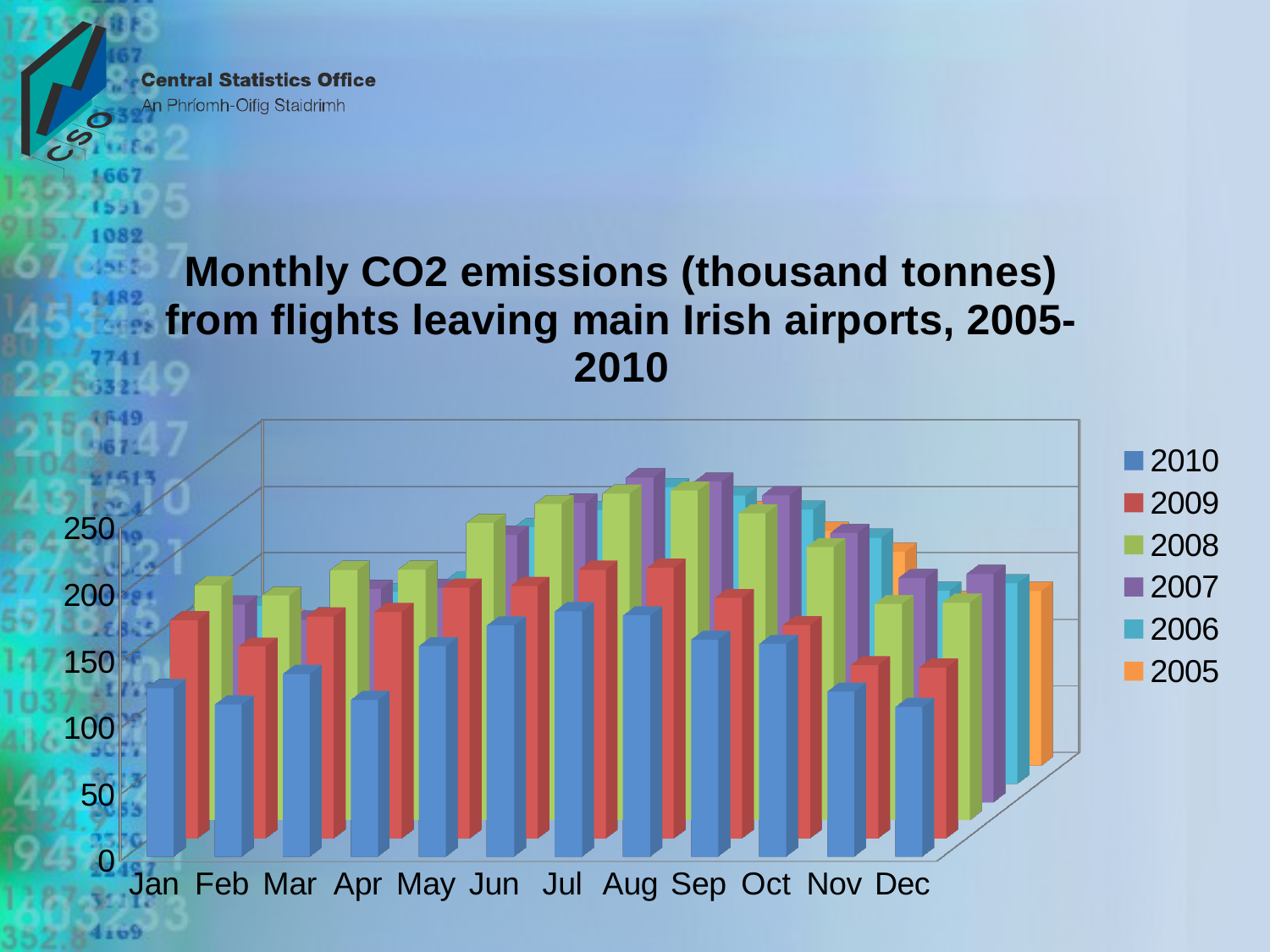
Is the 2010 value for Jan greater or less than 100? greater How many series does the legend list? 6 Which is larger for 2010: the value for May or the value for Feb? May Is the 2010 value for Dec greater or less than 150? less Is the 2010 value for Jul greater or less than 150? greater Which years are listed in the legend? 2010, 2009, 2008, 2007, 2006, 2005 Which is larger for 2010: the value for Jul or the value for Jan? Jul What colour represents the 2010 series? blue From Jul to Dec, do the 2010 values generally rise or fall? fall What kind of chart is shown on the slide? bar chart How many months (categories) are shown on the x axis? 12